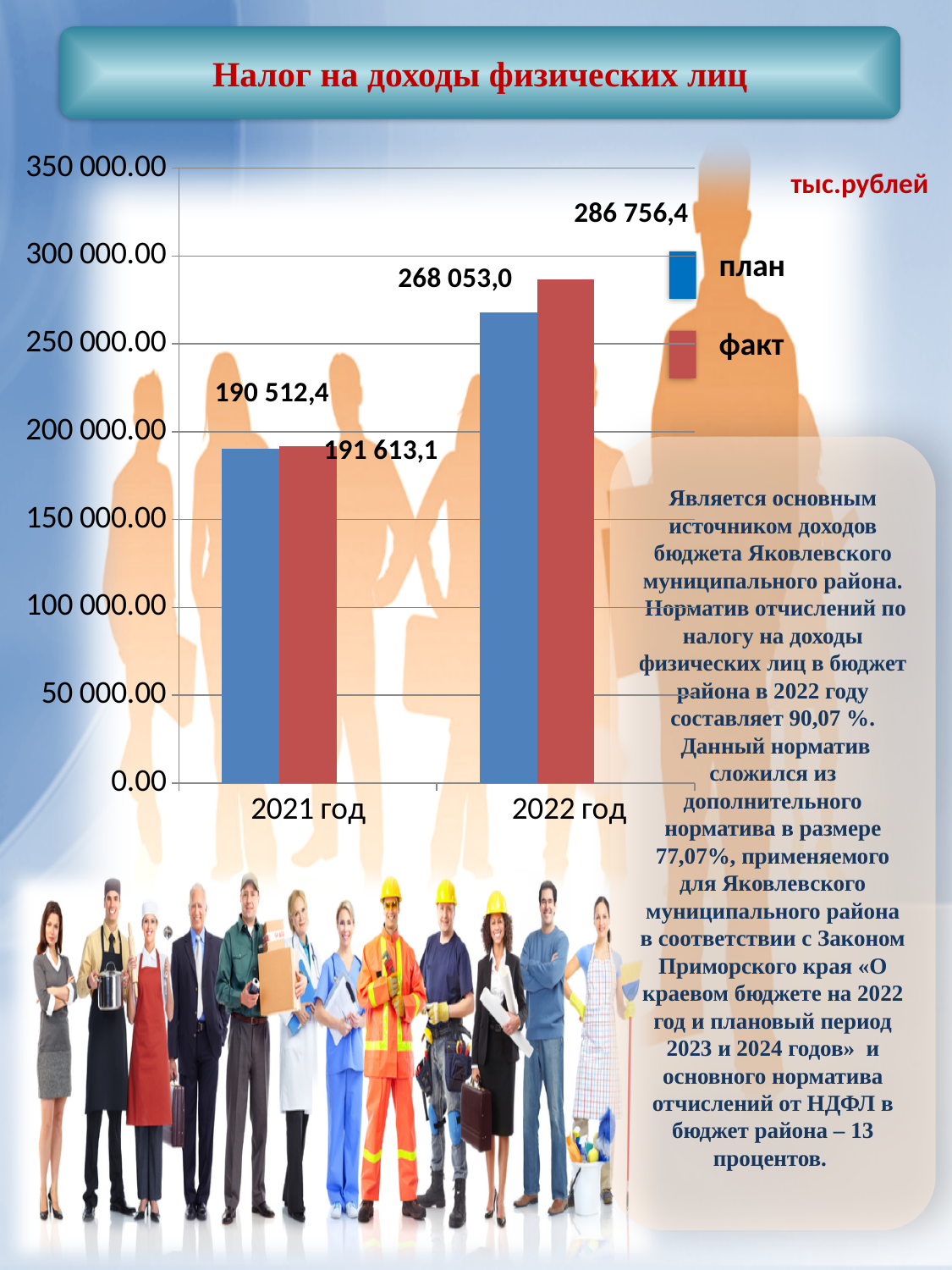
Which bar has the highest value on the chart? факт, 2022 год What is the факт value for 2021 год? 191 613,1 What is the план value for 2022 год? 268 053,0 What is the план value for 2021 год? 190 512,4 Which is larger for 2022 год, план or факт? факт What is the difference between the план values for 2022 год and 2021 год? 77 540,6 What kind of chart is shown on the slide? bar chart How many series does the legend list? 2 What is the факт value for 2022 год? 286 756,4 Which bar has the lowest value on the chart? план, 2021 год What is the difference between the факт and план values for 2022 год? 18 703,4 What unit is indicated for the chart values? тыс.рублей